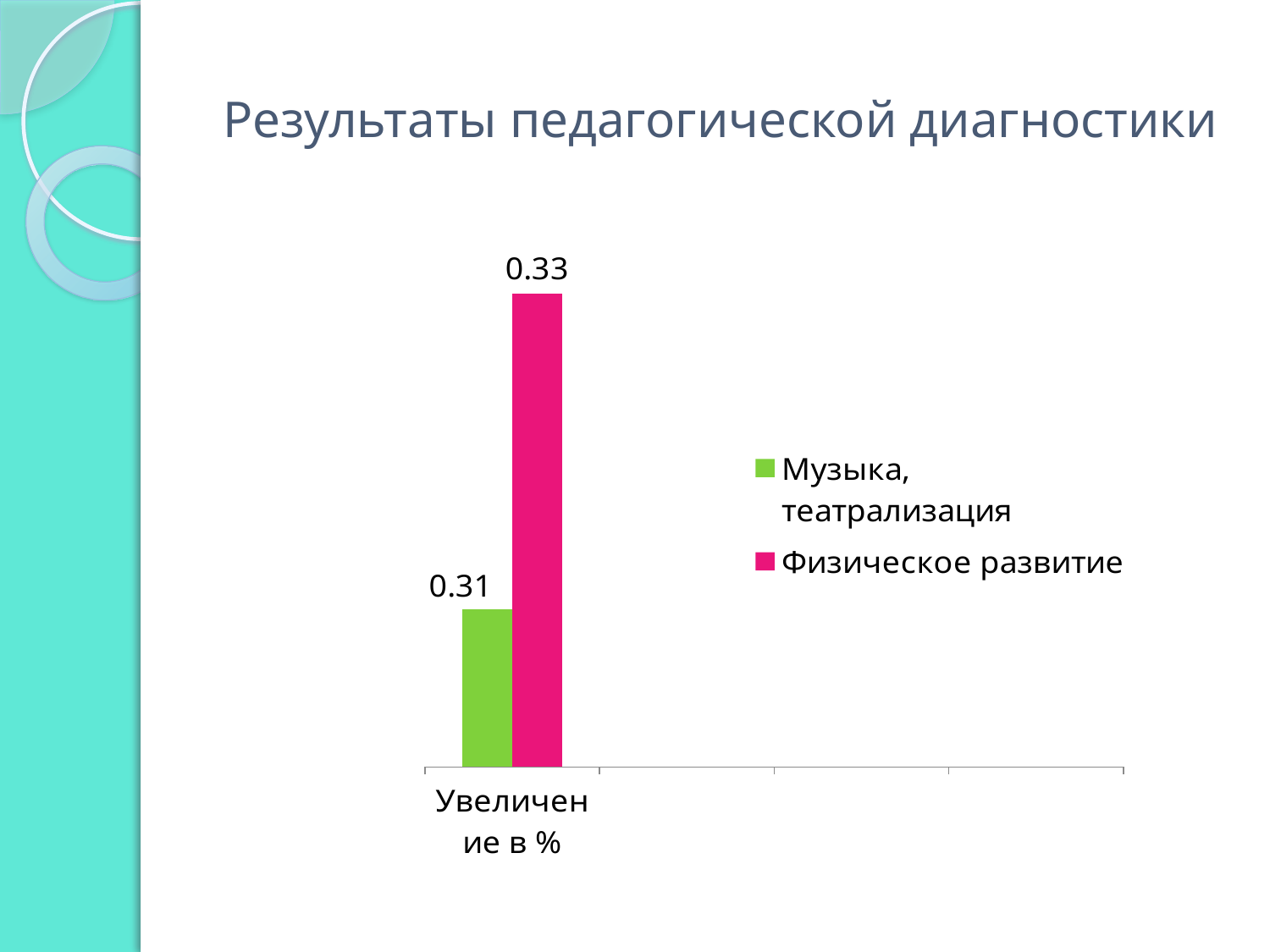
What is the value for Музыка, театрализация in the Увеличение в % category? 0.31 What colour is the bar for Физическое развитие? Pink How many categories are shown on the x axis? 1 Which series has the lowest value on the chart? Музыка, театрализация What is the title of the slide? Результаты педагогической диагностики What kind of chart is shown on the slide? Bar chart What is the value for Физическое развитие in the Увеличение в % category? 0.33 What is the difference between the values for Физическое развитие and Музыка, театрализация? 0.02 Which series has the higher value: Музыка, театрализация or Физическое развитие? Физическое развитие How many series does the legend list? 2